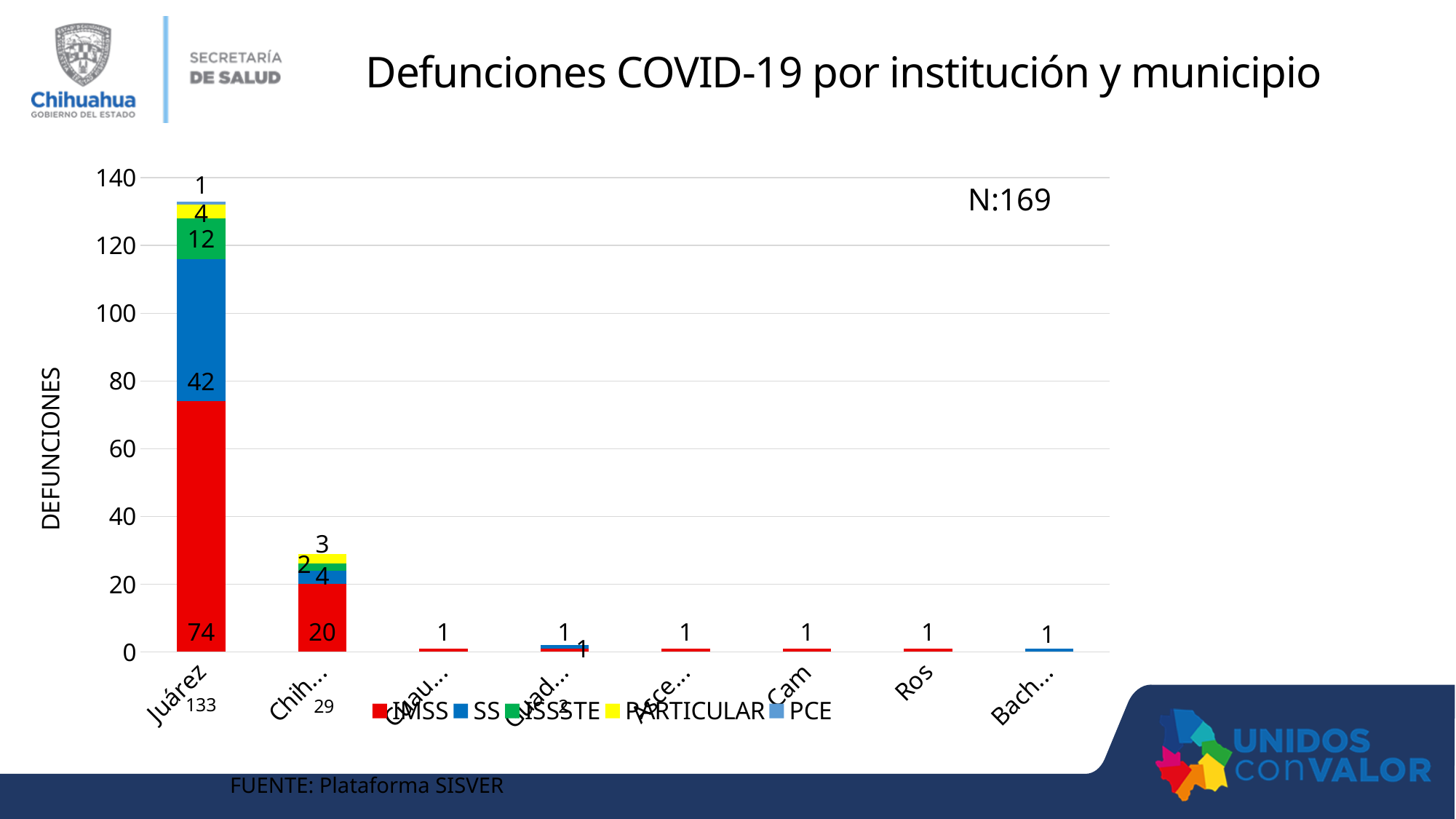
What is the value shown for Cam? 1 What is the PARTICULAR value for Juárez? 4 What is the ISSSTE value for Juárez? 12 How many municipalities (categories) are shown on the x axis? 8 Which is larger, the IMSS value for Juárez or the IMSS value for the second bar (Chih...)? Juárez How many series does the legend list? 5 What is the total of the stacked bar for Juárez? 133 What kind of chart is shown on the slide? Stacked bar chart Which municipality has the highest total number of deaths? Juárez What is the IMSS value for Juárez? 74 What is the SS value for Juárez? 42 What is the difference between the IMSS value and the SS value for Juárez? 32